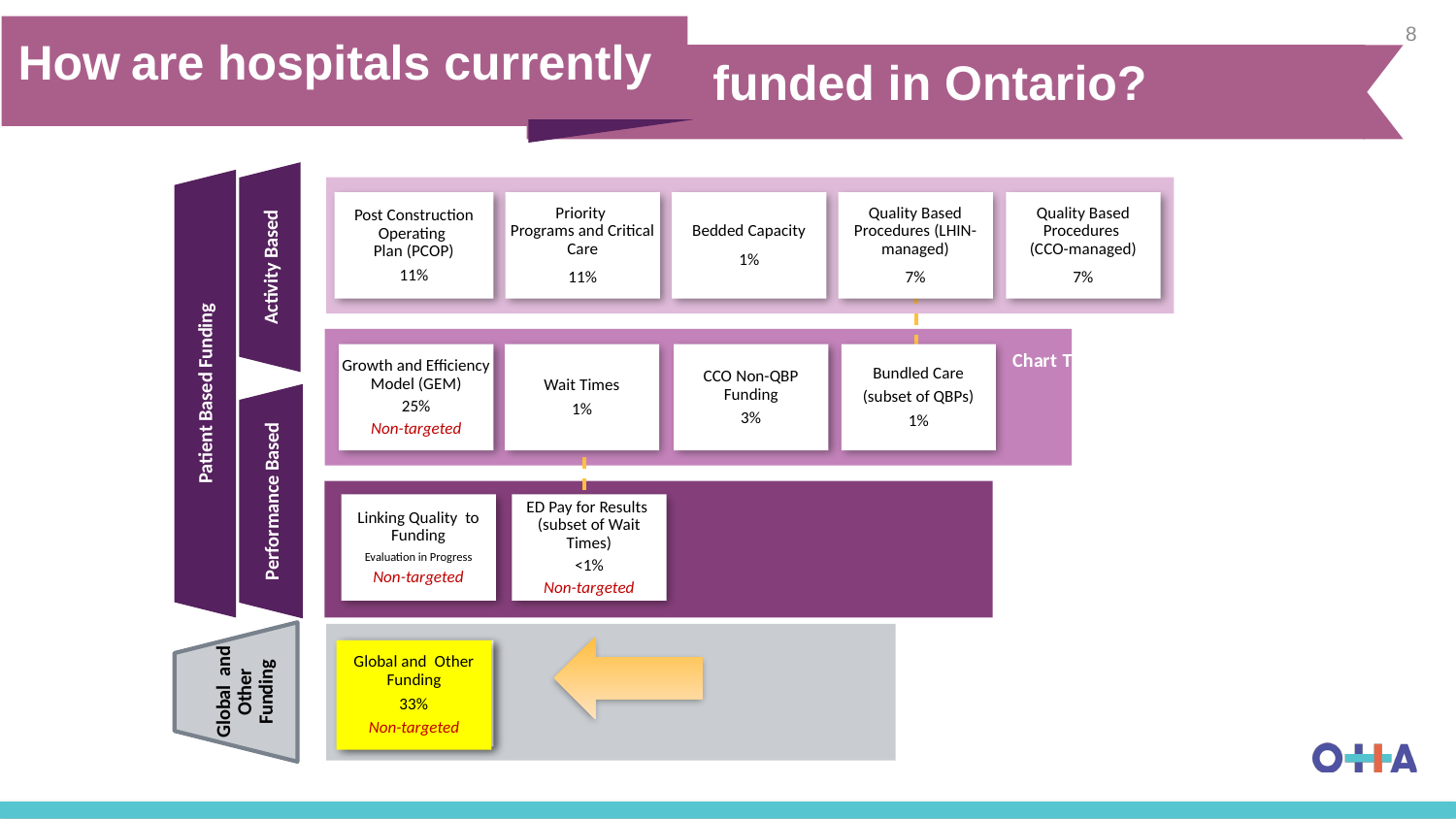
What percentage is shown for Quality Based Procedures (CCO-managed)? 7% What percentage is shown for the Growth and Efficiency Model (GEM)? 25% What colour is the Global and Other Funding box? Yellow What percentage is shown for Global and Other Funding? 33% How many funding boxes are shown in the Activity Based row? 5 Which funding stream has the highest percentage on the slide? Global and Other Funding What percentage is shown for Post Construction Operating Plan (PCOP)? 11% Which is larger, the percentage for Growth and Efficiency Model (GEM) or for Post Construction Operating Plan (PCOP)? Growth and Efficiency Model (GEM) What percentage is shown for Bundled Care (subset of QBPs)? 1% What percentage is shown for ED Pay for Results (subset of Wait Times)? <1% What is the difference in percentage points between Global and Other Funding and the Growth and Efficiency Model (GEM)? 8 percentage points What percentage is shown for CCO Non-QBP Funding? 3%